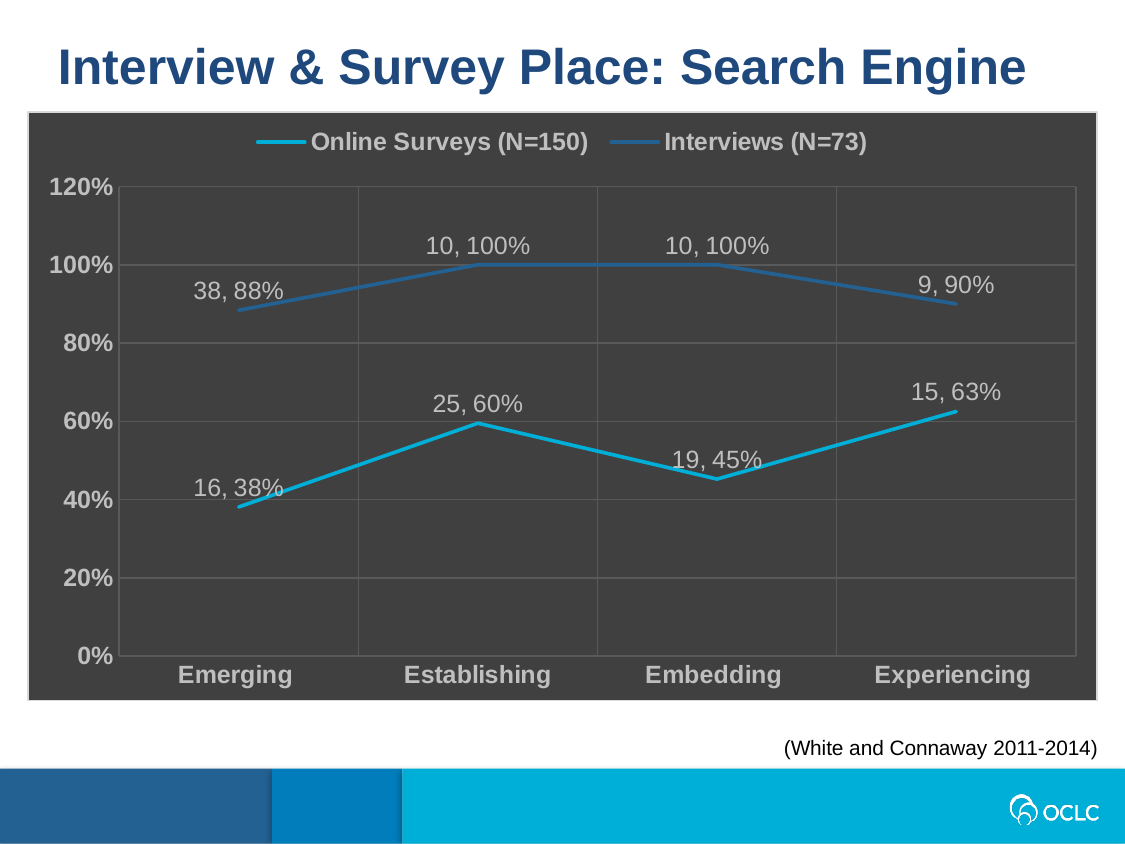
Which category has the highest percentage for Online Surveys? Experiencing How many categories are shown on the x axis? 4 What is the title of the slide? Interview & Survey Place: Search Engine What is the difference in percentage points between Interviews and Online Surveys at Emerging? 50 What type of chart is shown on the slide? line chart Does the Online Surveys percentage rise or fall from Establishing to Embedding? fall What is the count shown for Interviews at Emerging? 38 What is the percentage for Interviews at Experiencing? 90% Which category has the lowest percentage for Online Surveys? Emerging What is the percentage for Online Surveys at Establishing? 60% Which is larger at Embedding: the Online Surveys percentage or the Interviews percentage? Interviews How many series does the legend list? 2